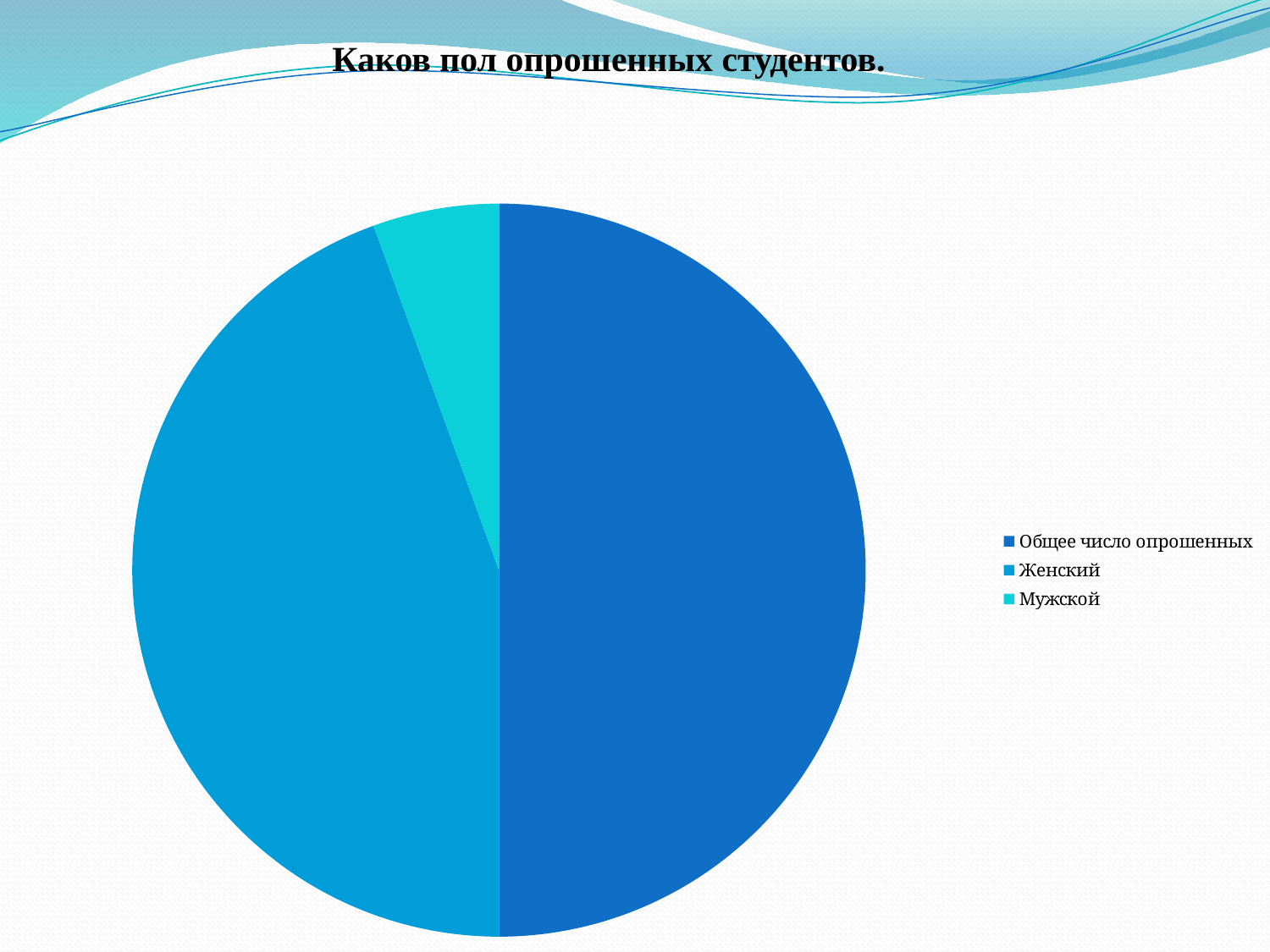
Which slice is larger, Общее число опрошенных or Женский? Общее число опрошенных How many entries does the legend list? 3 Which slice is larger, Женский or Мужской? Женский Which legend entry is shown in the lightest (cyan) colour? Мужской Which slice of the pie chart is the smallest? Мужской What is the title of the slide? Каков пол опрошенных студентов. What kind of chart is shown on the slide? pie chart How many slices does the pie chart have? 3 Which slice of the pie chart is the largest? Общее число опрошенных